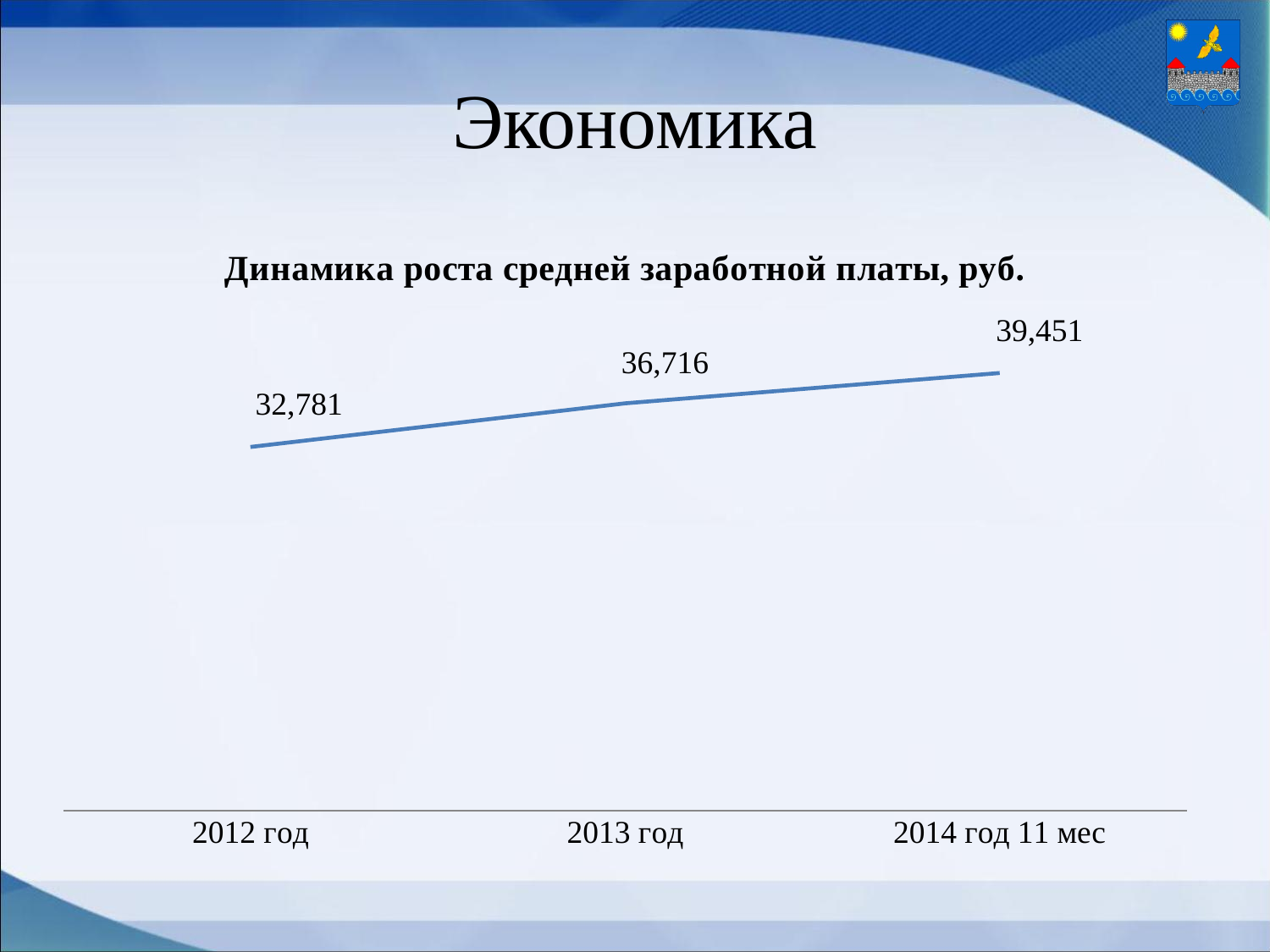
Do the values rise or fall from 2012 год to 2014 год 11 мес? rise What kind of chart is shown on the slide? line chart What is the average salary value shown for 2012 год? 32,781 Which is larger, the value for 2013 год or the value for 2012 год? 2013 год How many data points are plotted on the chart? 3 What is the difference between the values for 2013 год and 2012 год? 3,935 What is the title of the chart? Динамика роста средней заработной платы, руб. What is the difference between the values for 2014 год 11 мес and 2013 год? 2,735 What is the average salary value shown for 2013 год? 36,716 Which period has the lowest average salary value? 2012 год Which period has the highest average salary value? 2014 год 11 мес What is the average salary value shown for 2014 год 11 мес? 39,451